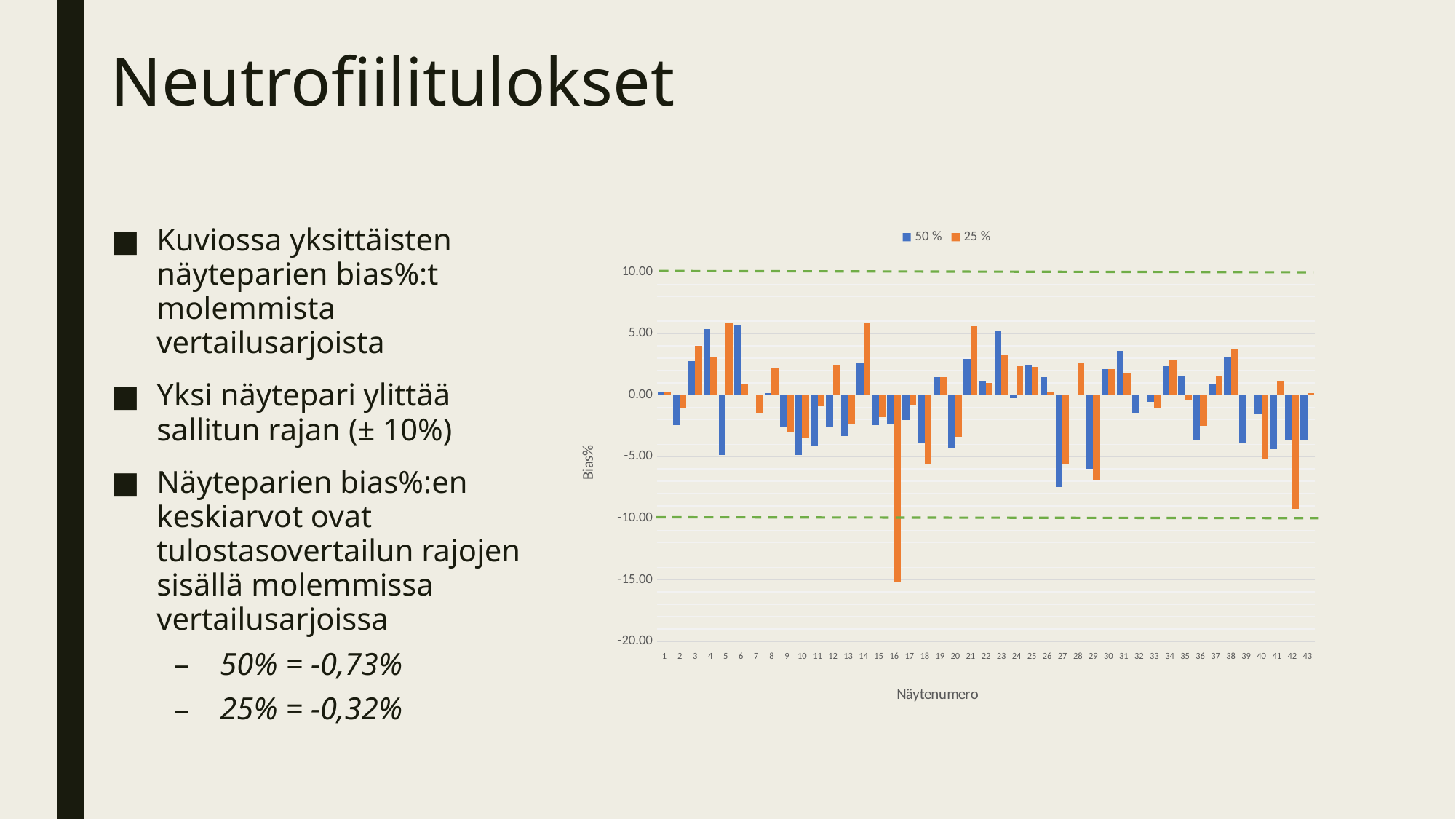
How many series does the chart legend list? 2 What are the two series named in the chart legend? 50 % and 25 % What is the title of the chart's y axis? Bias% Which sample number has the lowest value in the 25 % series? 16 Is the 50 % value for sample 27 greater or less than -5.00? less Is the 25 % value for sample 14 greater or less than 5.00? greater For sample 16, which series has the larger value, 50 % or 25 %? 50 % What kind of chart is shown on the slide? bar chart Is the 25 % value for sample 42 greater or less than -5.00? less How many sample numbers (Näytenumero) are shown on the x axis of the chart? 43